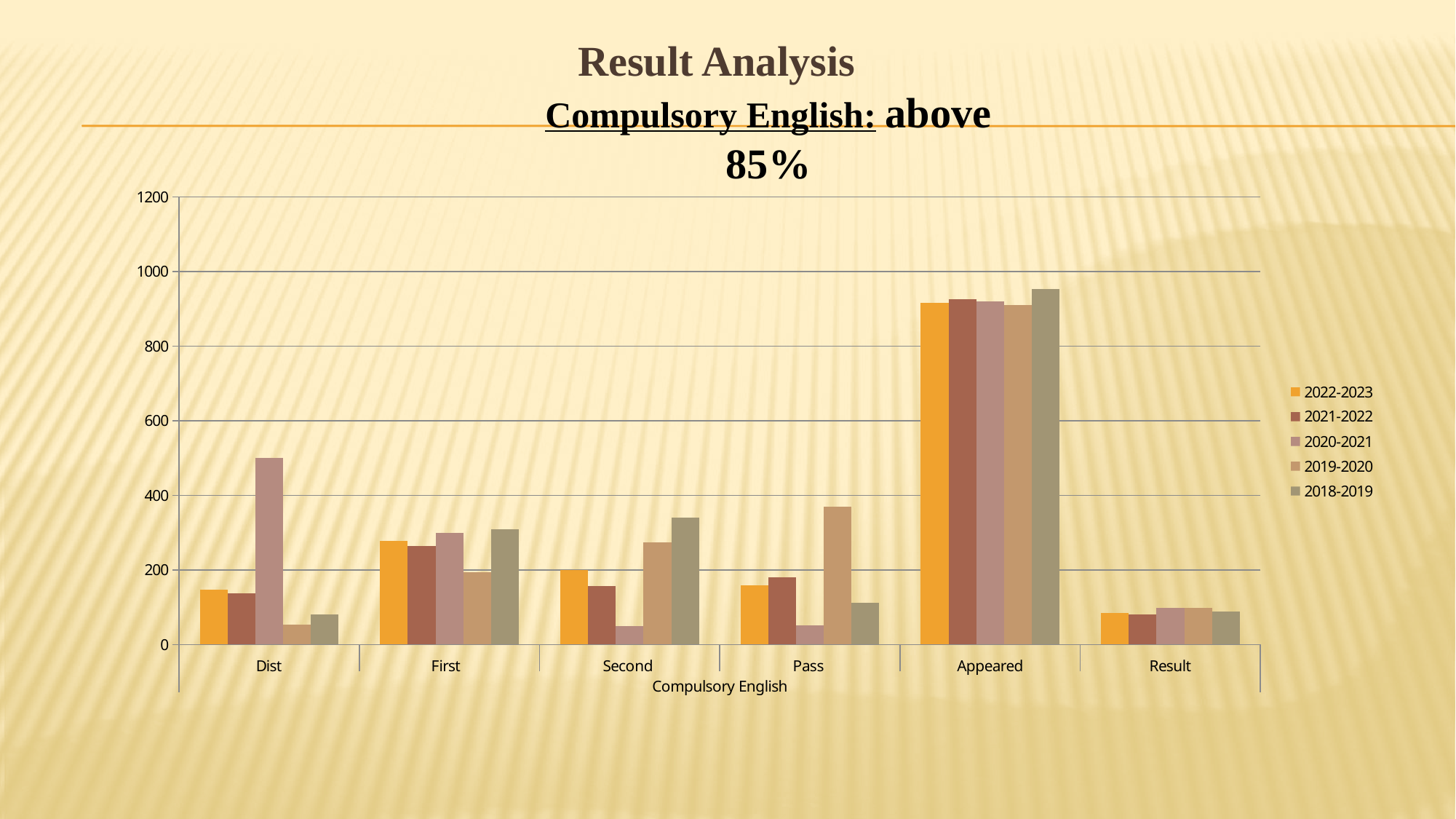
What kind of chart is shown on the slide? bar chart Which category has the highest bars in the chart? Appeared Which series is listed first in the chart's legend? 2022-2023 In the Dist category, which is larger: the 2020-2021 bar or the 2019-2020 bar? 2020-2021 How many categories are shown along the x axis of the chart? 6 Is the value for 2020-2021 in the Dist category greater or less than 400? greater In the Pass category, which is larger: the 2019-2020 bar or the 2018-2019 bar? 2019-2020 In the Second category, which series has the lowest bar? 2020-2021 How many series does the chart's legend list? 5 Is the value for 2022-2023 in the Result category greater or less than 200? less What is the title shown below the x axis of the chart? Compulsory English Is the value for 2018-2019 in the Appeared category greater or less than 800? greater